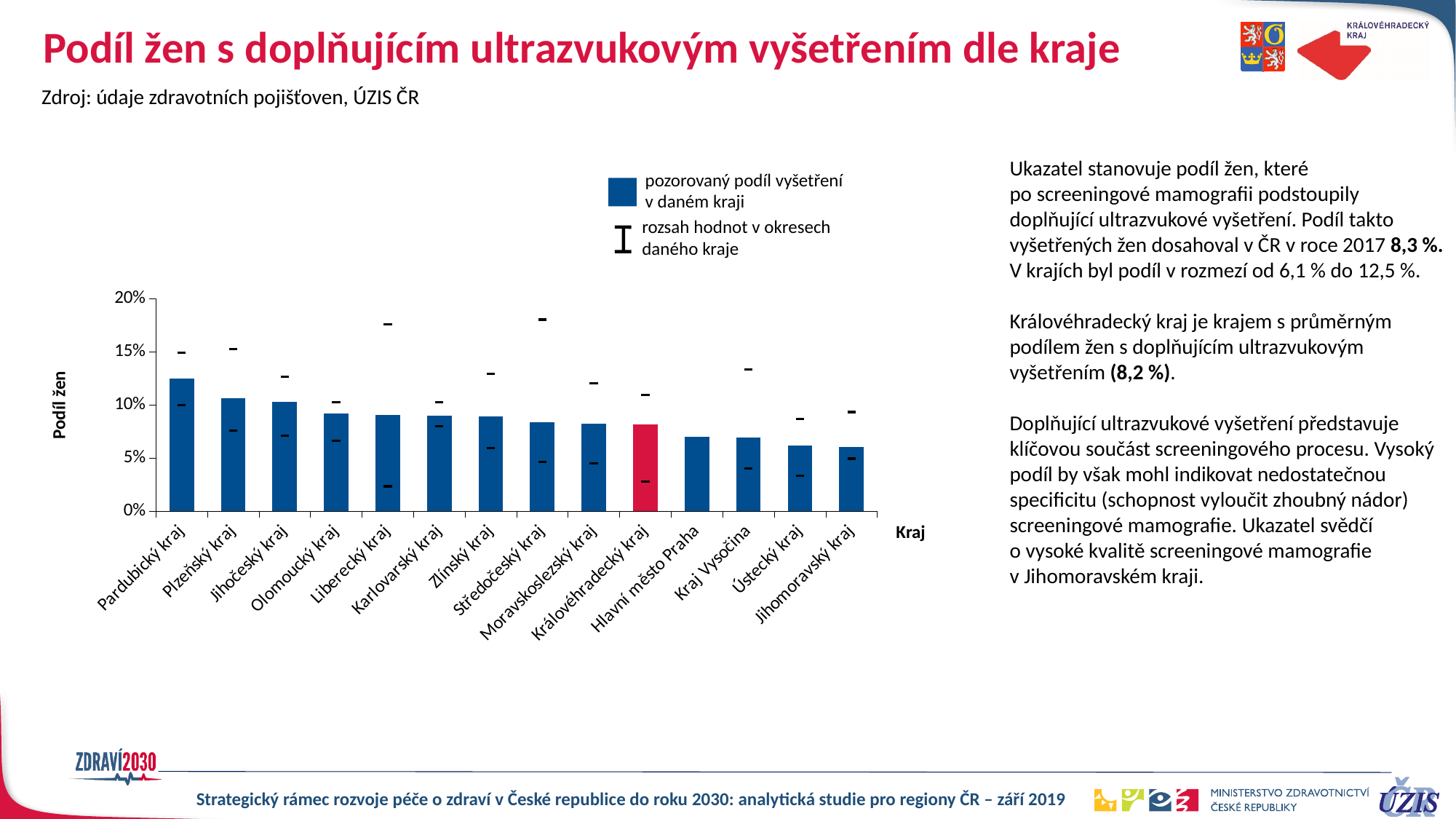
Is the value for Královéhradecký kraj greater or less than 10%? less Which region's bar is highlighted in red in the chart? Královéhradecký kraj What kind of chart is shown on the slide? bar chart Is the value for Jihomoravský kraj greater or less than 5%? greater Which has a higher value, Hlavní město Praha or Jihomoravský kraj? Hlavní město Praha How many regions (kraje) are shown on the x axis of the chart? 14 Do the bar values rise or fall from left to right along the x axis? fall Which region has the highest observed share of women with supplementary ultrasound examination? Pardubický kraj Which has a higher value, Pardubický kraj or Plzeňský kraj? Pardubický kraj Is the value for Hlavní město Praha greater or less than 10%? less What is the label of the vertical axis of the chart? Podíl žen